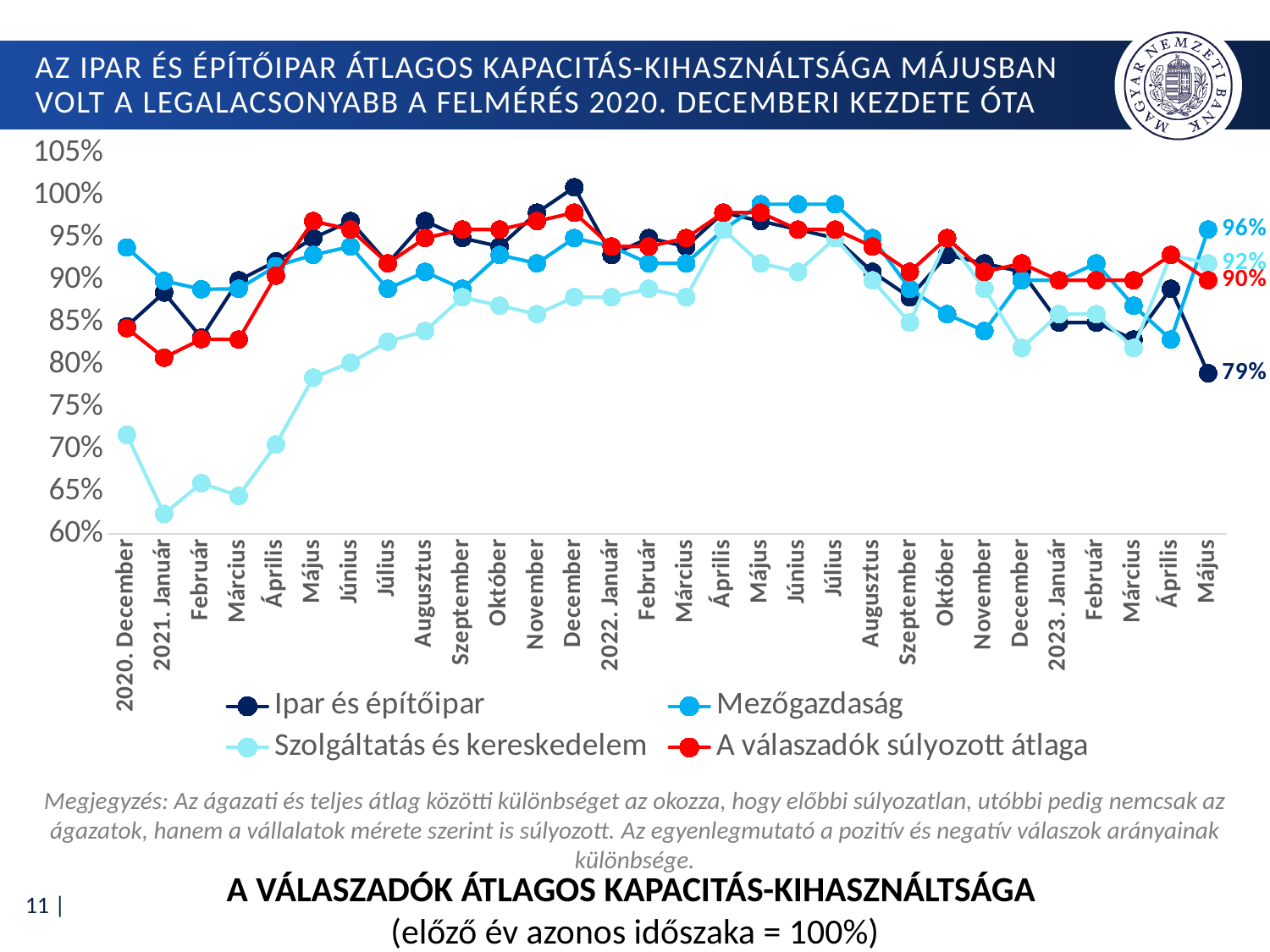
What is the value for Mezőgazdaság in Május 2023? 96% What kind of chart is shown on the slide? line chart Does the Szolgáltatás és kereskedelem line rise or fall from 2021. Január to 2021. Május? rise What is the difference between the Mezőgazdaság and Ipar és építőipar values in Május 2023? 17 percentage points What colour is the line for A válaszadók súlyozott átlaga? red In Május 2023, which is larger: Szolgáltatás és kereskedelem or A válaszadók súlyozott átlaga? Szolgáltatás és kereskedelem How many months (data points) are plotted along the x axis? 30 Is the value for Szolgáltatás és kereskedelem in 2021. Január greater or less than 65%? less What is the value for A válaszadók súlyozott átlaga in Május 2023? 90% What is the value for Ipar és építőipar in Május 2023? 79% How many series does the legend list? 4 Which series has the lowest value in Május 2023? Ipar és építőipar